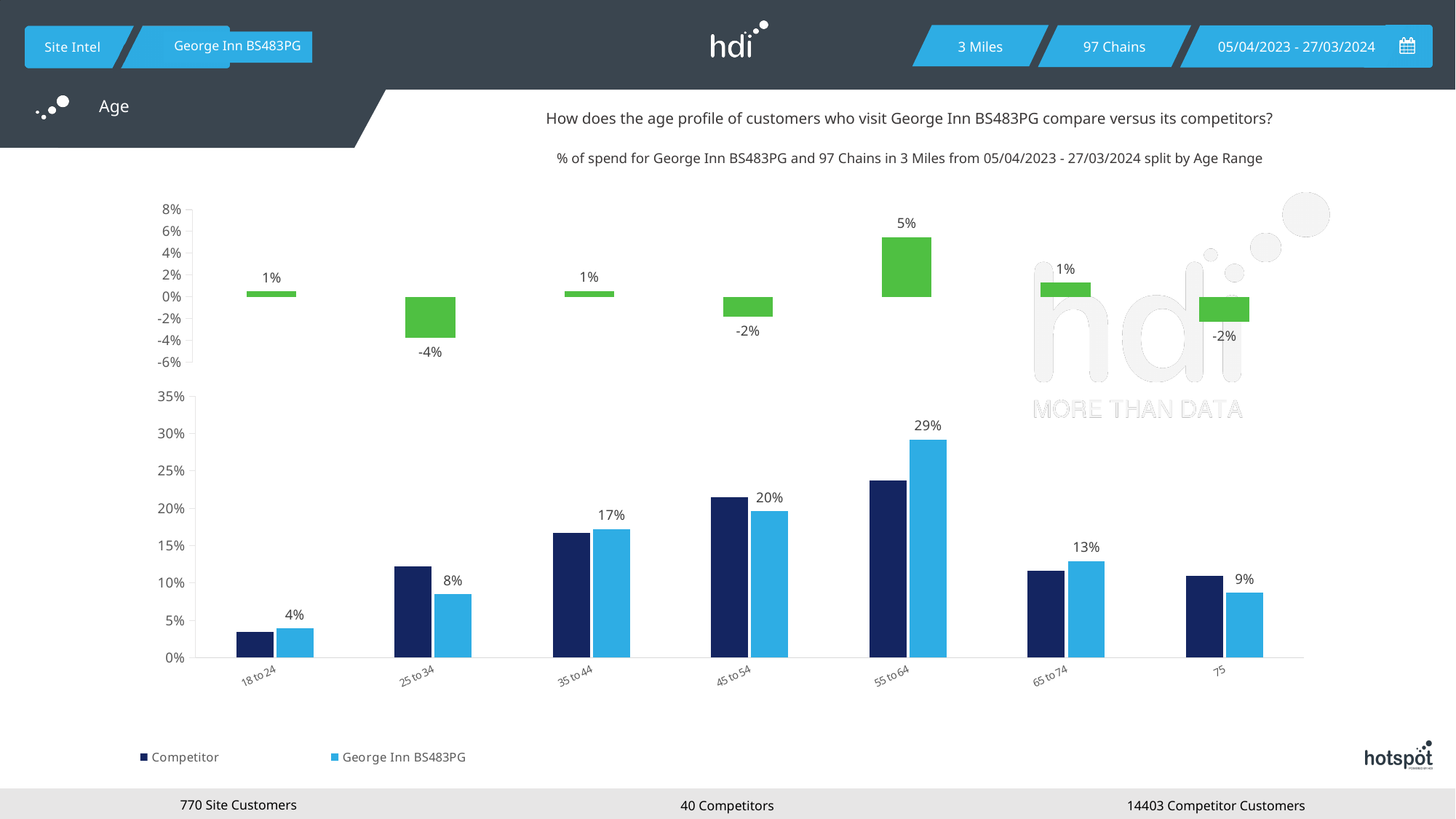
In the upper chart, what is the value shown for the 55 to 64 age range? 5% In the lower bar chart, is the Competitor value for 45 to 54 greater or less than 20%? greater In the lower bar chart, which is larger for the 25 to 34 age range: Competitor or George Inn BS483PG? Competitor In the lower bar chart, what is the value for George Inn BS483PG in the 18 to 24 age range? 4% In the lower bar chart, which age range has the lowest value for George Inn BS483PG? 18 to 24 In the lower bar chart, which age range has the highest value for George Inn BS483PG? 55 to 64 How many series does the legend of the lower bar chart list? 2 In the upper chart, which age range has the lowest value? 25 to 34 In the lower bar chart, is the Competitor value for 25 to 34 greater or less than 15%? less In the lower bar chart, what is the difference between the George Inn BS483PG values for 55 to 64 and 45 to 54? 9% In the lower bar chart, what is the value for George Inn BS483PG in the 55 to 64 age range? 29% How many age range categories are shown on the x axis of the lower bar chart? 7